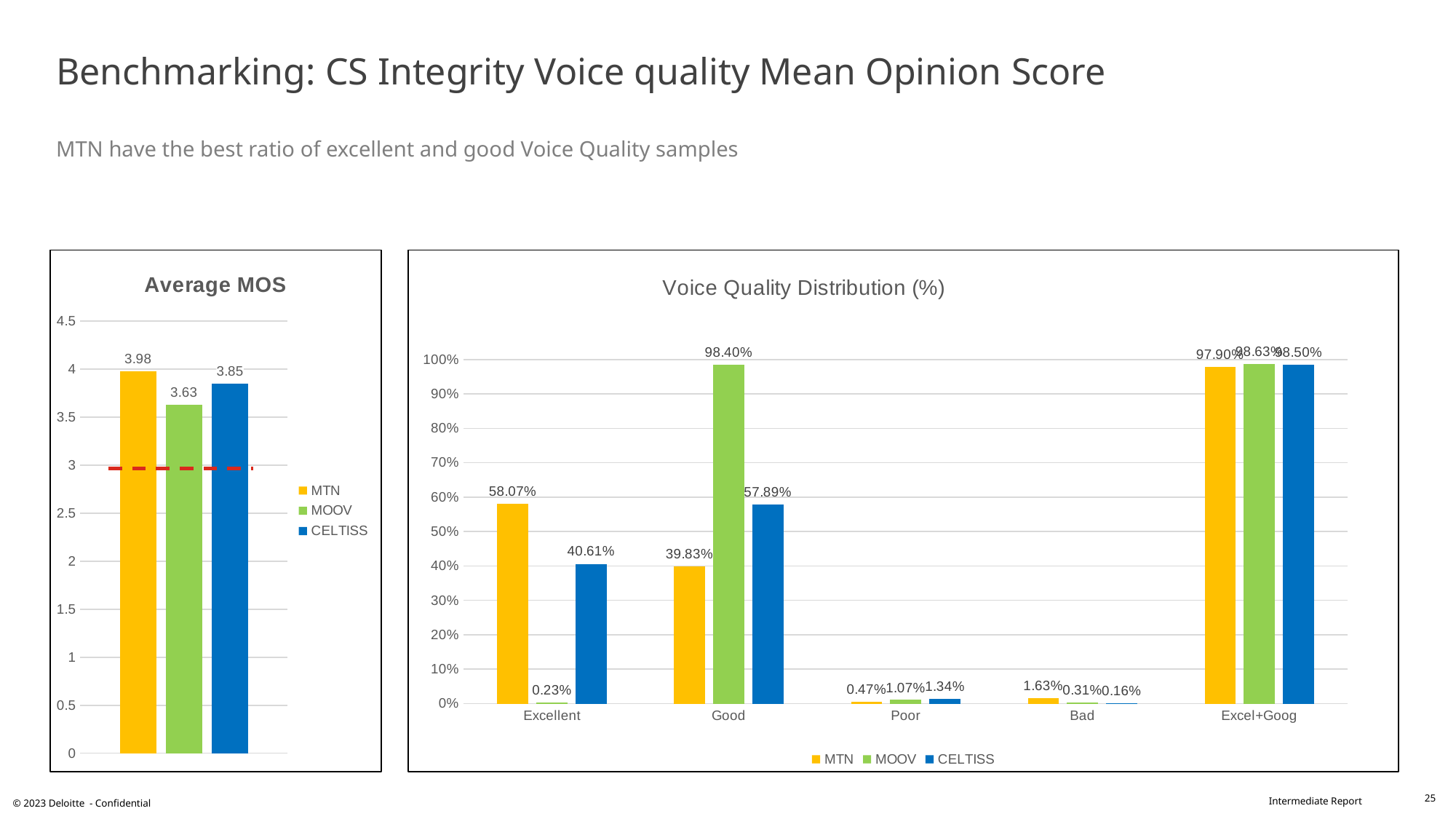
In the Voice Quality Distribution (%) chart, what is the value for CELTISS in the Excellent category? 40.61% In the Voice Quality Distribution (%) chart, what is the difference between MTN and CELTISS in the Good category? 18.06% In the Voice Quality Distribution (%) chart, which operator has the lowest value in the Bad category? CELTISS In the Voice Quality Distribution (%) chart, what is the value for MOOV in the Good category? 98.40% What kind of chart is the Voice Quality Distribution (%) chart? Bar chart In the Voice Quality Distribution (%) chart, which is larger: MTN in Poor or MTN in Bad? MTN in Bad In the Voice Quality Distribution (%) chart, which operator has the highest value in the Excellent category? MTN In the Average MOS chart, how many series does the legend list? 3 In the Average MOS chart, what is the difference between MTN and CELTISS? 0.13 In the Voice Quality Distribution (%) chart, how many categories are shown on the x axis? 5 In the Average MOS chart, what is the value for MTN? 3.98 In the Average MOS chart, which operator has the lowest average MOS? MOOV